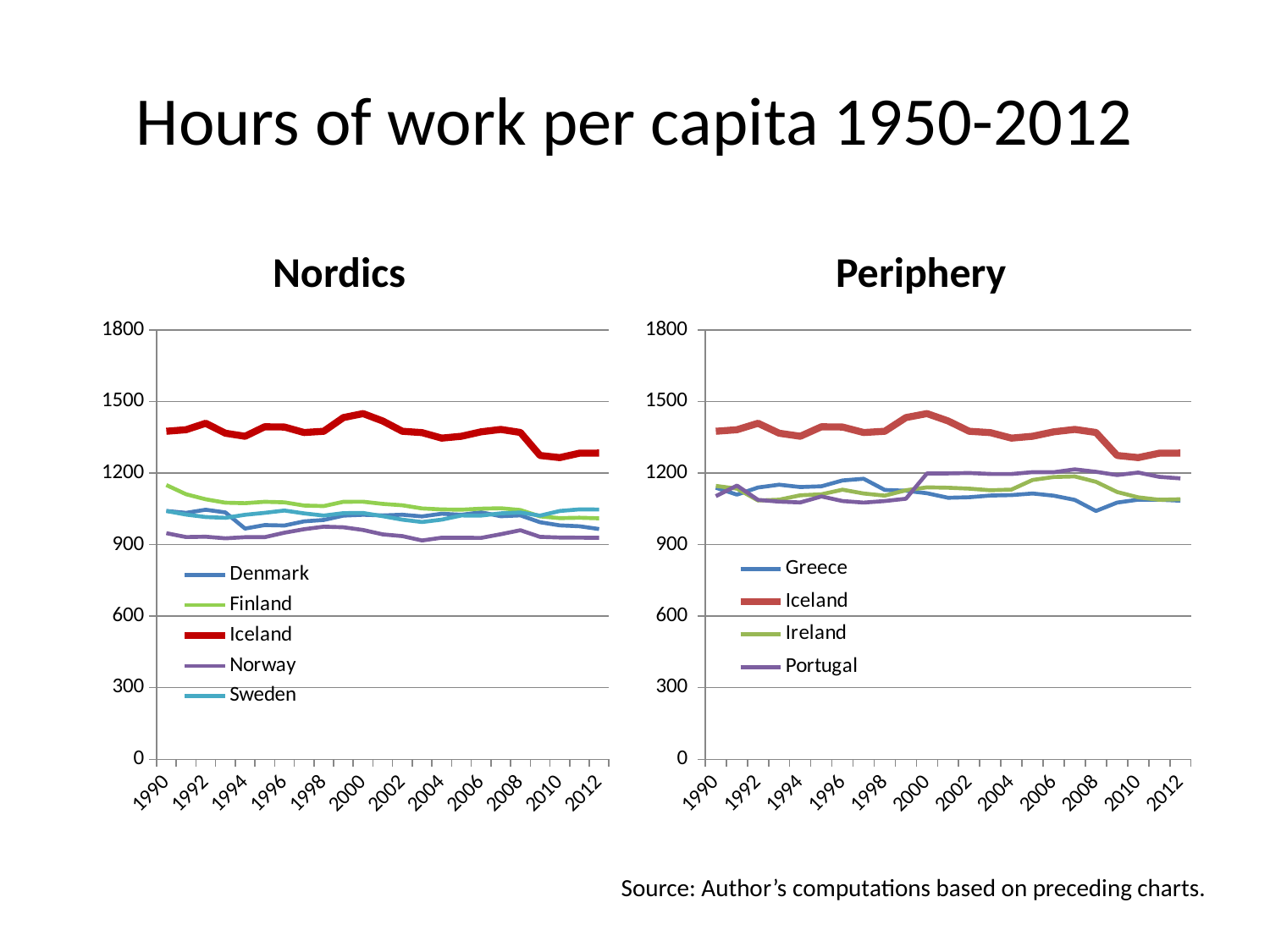
In the Nordics chart, does the Iceland line rise or fall from 1990 to 2012? fall In the Nordics chart, is the value for Iceland in 1990 greater or less than 1200? greater How many series does the legend of the Nordics chart list? 5 How many series does the legend of the Periphery chart list? 4 In the Periphery chart, which country has the highest hours of work per capita in 2000? Iceland In the Periphery chart, which country has the lowest hours of work per capita in 2008? Greece What kind of chart is the Nordics chart? line chart In the Nordics chart, which country has the highest hours of work per capita throughout the period? Iceland In the Nordics chart, which country has the lowest hours of work per capita in 2012? Norway In the Periphery chart, which is larger in 2012, Iceland or Greece? Iceland Which country appears in the legends of both the Nordics and Periphery charts? Iceland In the Periphery chart, is the value for Greece in 2008 greater or less than 1200? less